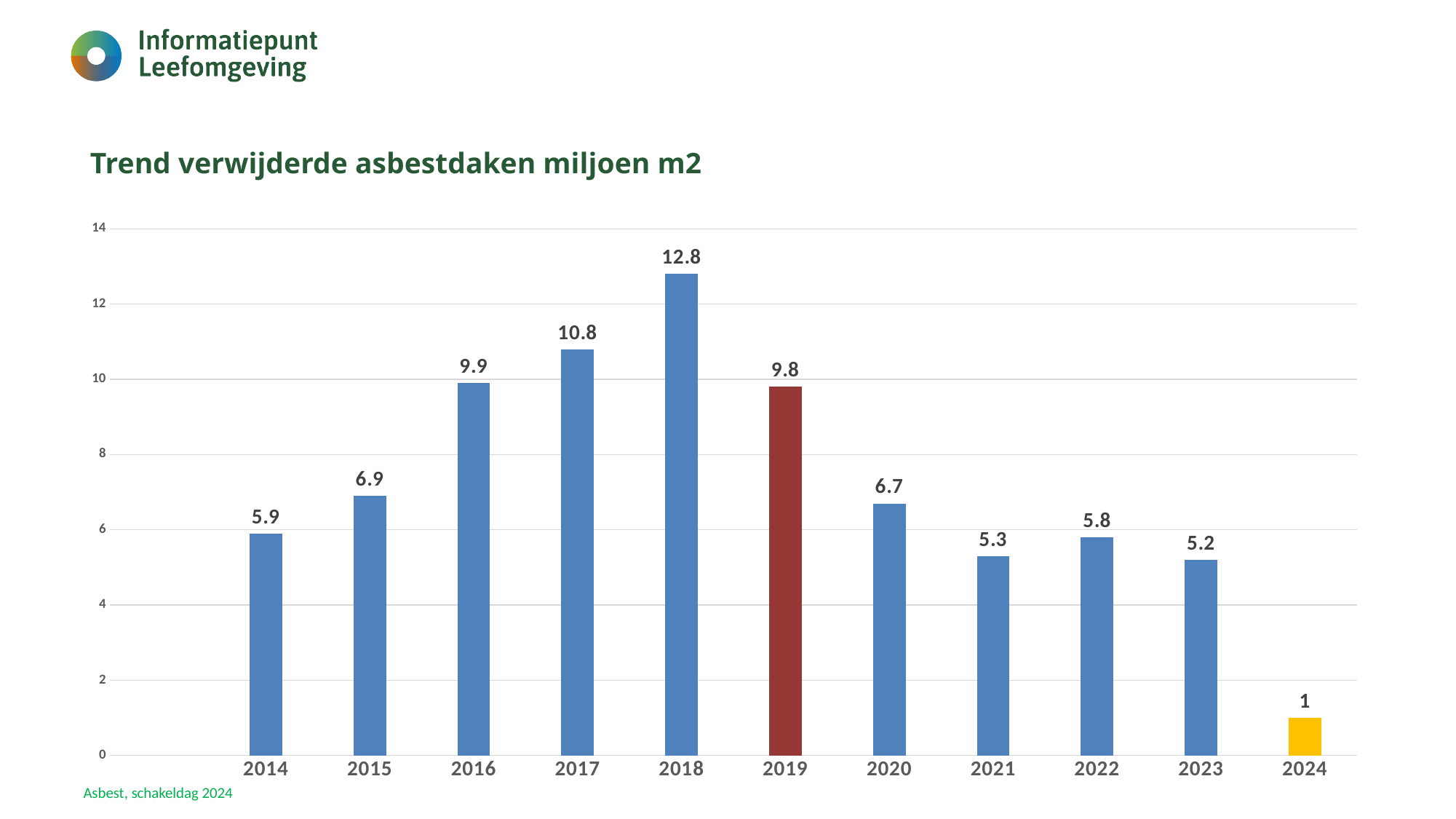
What is the value for 2024? 1 How many years are shown on the x axis? 11 What is the value for 2018? 12.8 Which year has the highest value? 2018 What is the difference between the values for 2018 and 2019? 3 Which is larger, the value for 2015 or the value for 2020? 2015 What is the value for 2019? 9.8 What kind of chart is this? Bar chart Is the value for 2017 greater or less than 10? greater Which year has the lowest value? 2024 What is the title of the chart? Trend verwijderde asbestdaken miljoen m2 Do the values rise or fall from 2018 to 2024? Fall